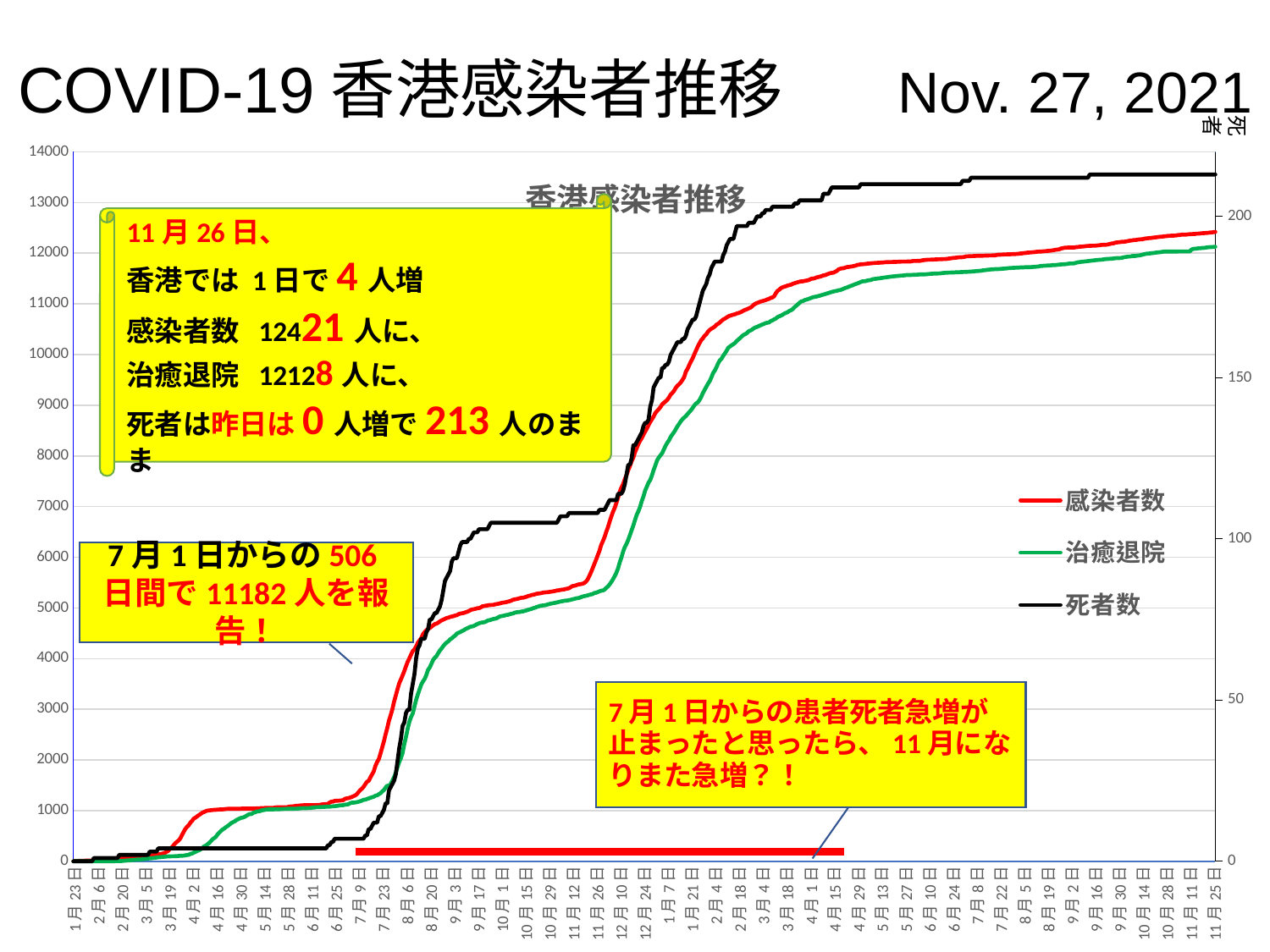
Which series is drawn with the black line? 死者数 At the right end of the chart (11月25日), is the value of 死者数 on the right axis greater or less than 200? greater Does the 感染者数 line rise or fall overall from left to right along the x axis? rise Around 8月6日 (2020), which series has the larger value: 感染者数 or 治癒退院? 感染者数 What kind of chart is shown on the slide? line chart Around 4月16日 (2020), is the value of 感染者数 greater or less than 2000? less At the right end of the chart (11月25日), is the value of 治癒退院 on the left axis greater or less than 11000? greater What is the title printed on the chart? 香港感染者推移 What are the three series named in the chart's legend? 感染者数, 治癒退院, 死者数 How many series does the chart's legend list? 3